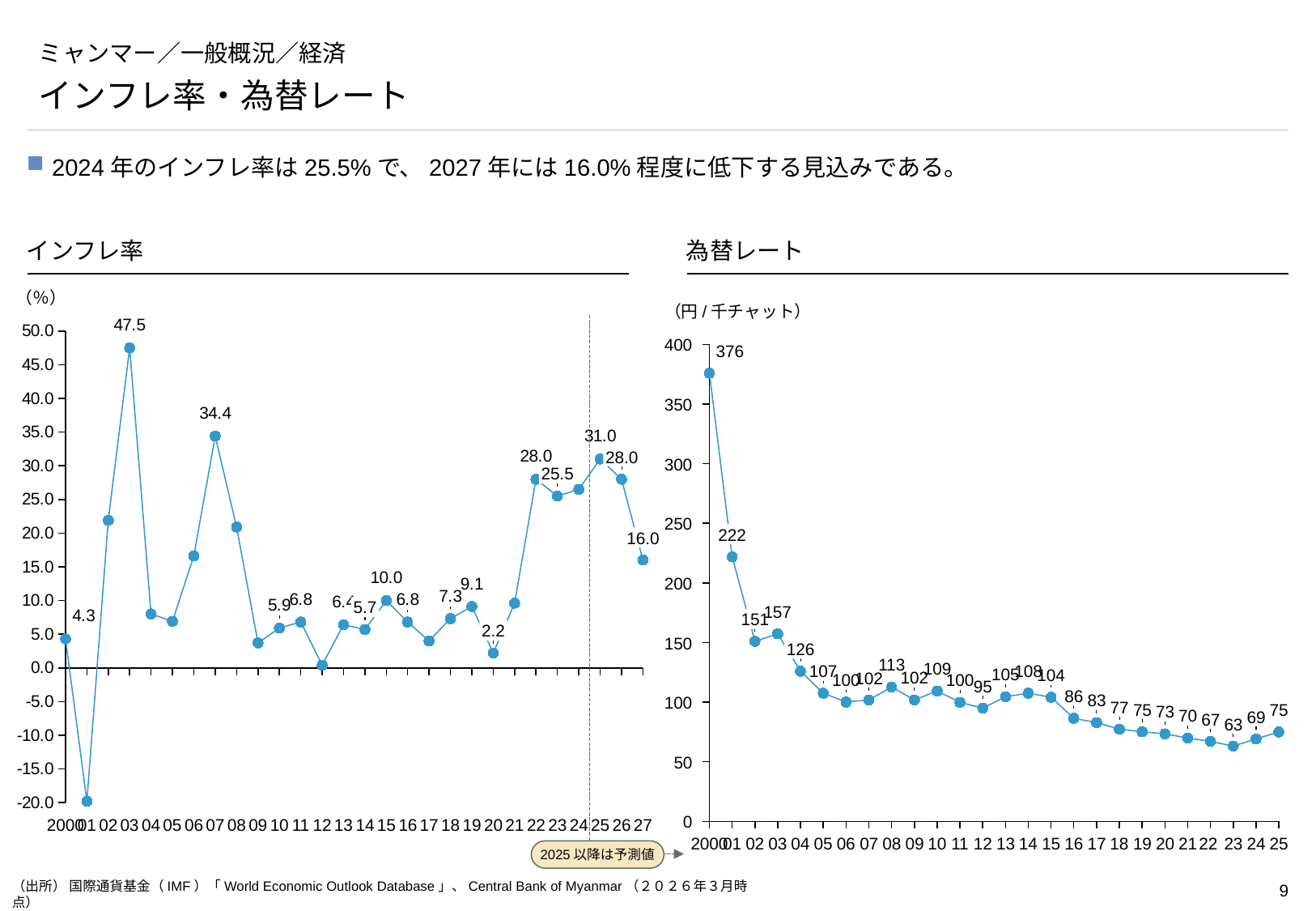
In the インフレ率 chart, is the value for 2001 greater or less than -15.0? less In the 為替レート chart, what is the exchange rate for 2023? 63 In the インフレ率 chart, what is the inflation rate for 2023? 25.5 In the 為替レート chart, what is the exchange rate for 2000? 376 In the 為替レート chart, which year has the lowest exchange rate? 2023 In the インフレ率 chart, which year has the lowest inflation rate? 2001 In the インフレ率 chart, what is the inflation rate for 2003? 47.5 In the 為替レート chart, what is the difference between the 2000 value and the 2001 value? 154 In the 為替レート chart, which is larger, the value for 2008 or the value for 2010? 2008 What kind of chart is the 為替レート chart? line chart In the インフレ率 chart, what is the difference between the 2025 value and the 2027 value? 15.0 In the インフレ率 chart, which year has the highest inflation rate? 2003